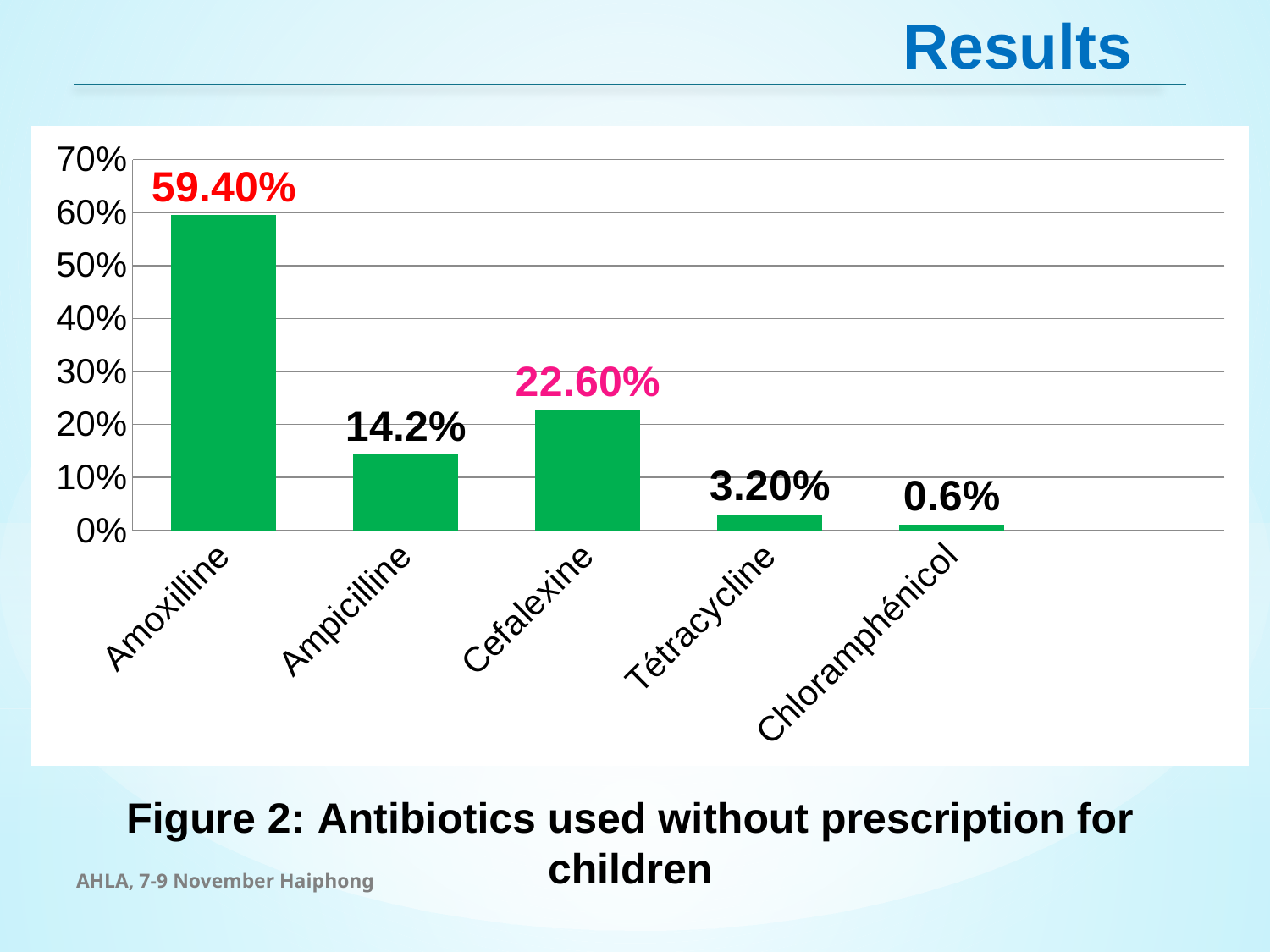
What kind of chart is shown on the slide? Bar chart What is the difference between the values for Amoxilline and Cefalexine? 36.80% What is the value for Tétracycline? 3.20% What is the value for Chloramphénicol? 0.6% What is the value for Amoxilline? 59.40% What is the value for Ampicilline? 14.2% Which antibiotic has the highest value? Amoxilline How many antibiotics are shown on the x axis? 5 What is the caption of the figure below the chart? Figure 2: Antibiotics used without prescription for children Which is larger, the value for Ampicilline or the value for Cefalexine? Cefalexine Which antibiotic has the lowest value? Chloramphénicol What is the value for Cefalexine? 22.60%